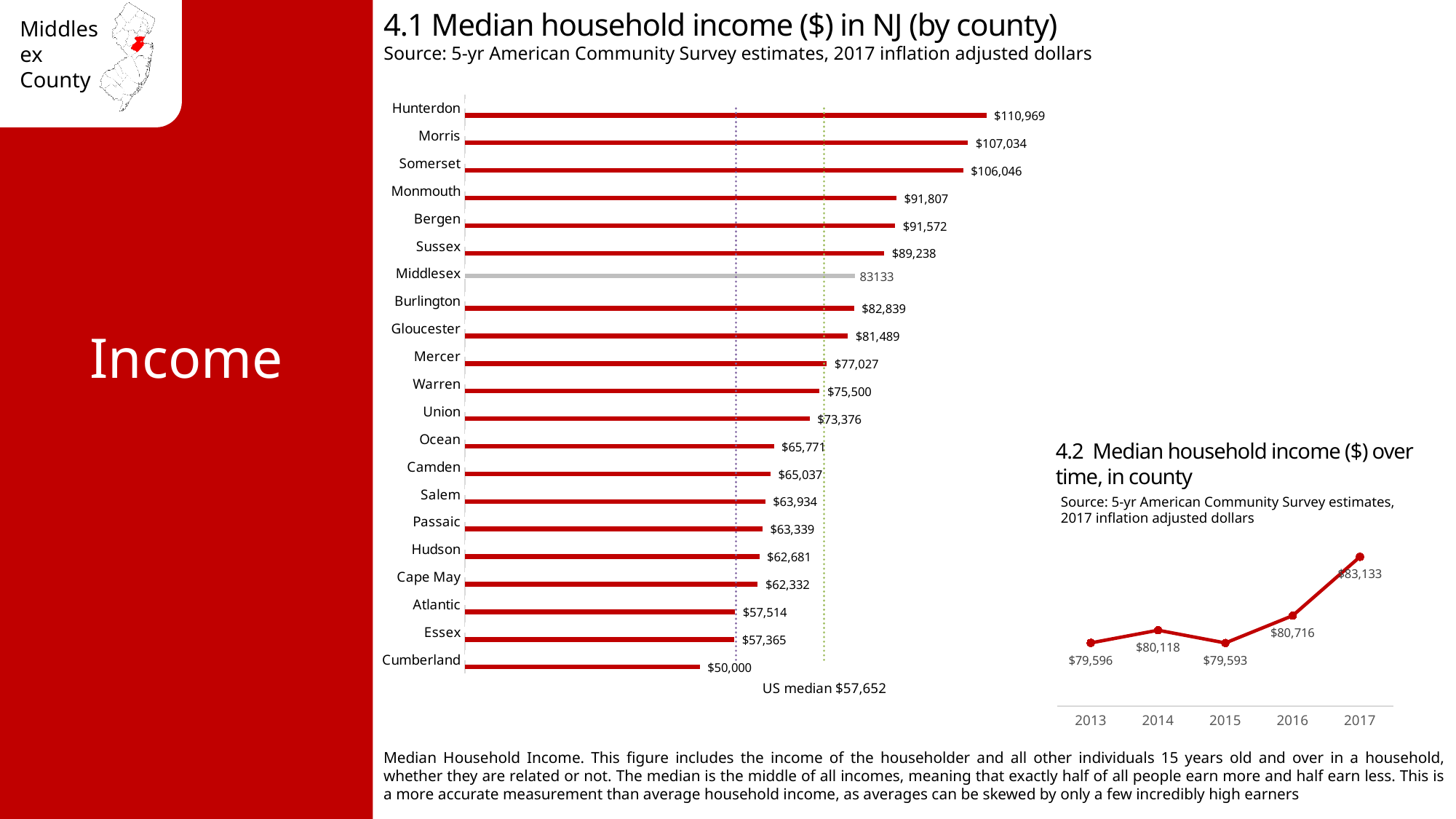
In chart 4.1, how many counties are plotted? 21 In chart 4.2, which year has the lowest median household income? 2015 In chart 4.1, what is the median household income for Middlesex? 83133 In chart 4.1 (Median household income in NJ by county), what is the median household income for Hunterdon? $110,969 In chart 4.1, which county has a higher median household income, Monmouth or Sussex? Monmouth In chart 4.2 (Median household income over time, in county), what is the value for 2017? $83,133 In chart 4.1, which county has the highest median household income? Hunterdon In chart 4.2, what is the difference between the 2017 and 2013 values? $3,537 In chart 4.1, what is the difference between the median household income of Hunterdon and Cumberland? $60,969 In chart 4.1, what US median value is noted on the chart? $57,652 What type of chart is chart 4.1? Bar chart In chart 4.1, which county has the lowest median household income? Cumberland